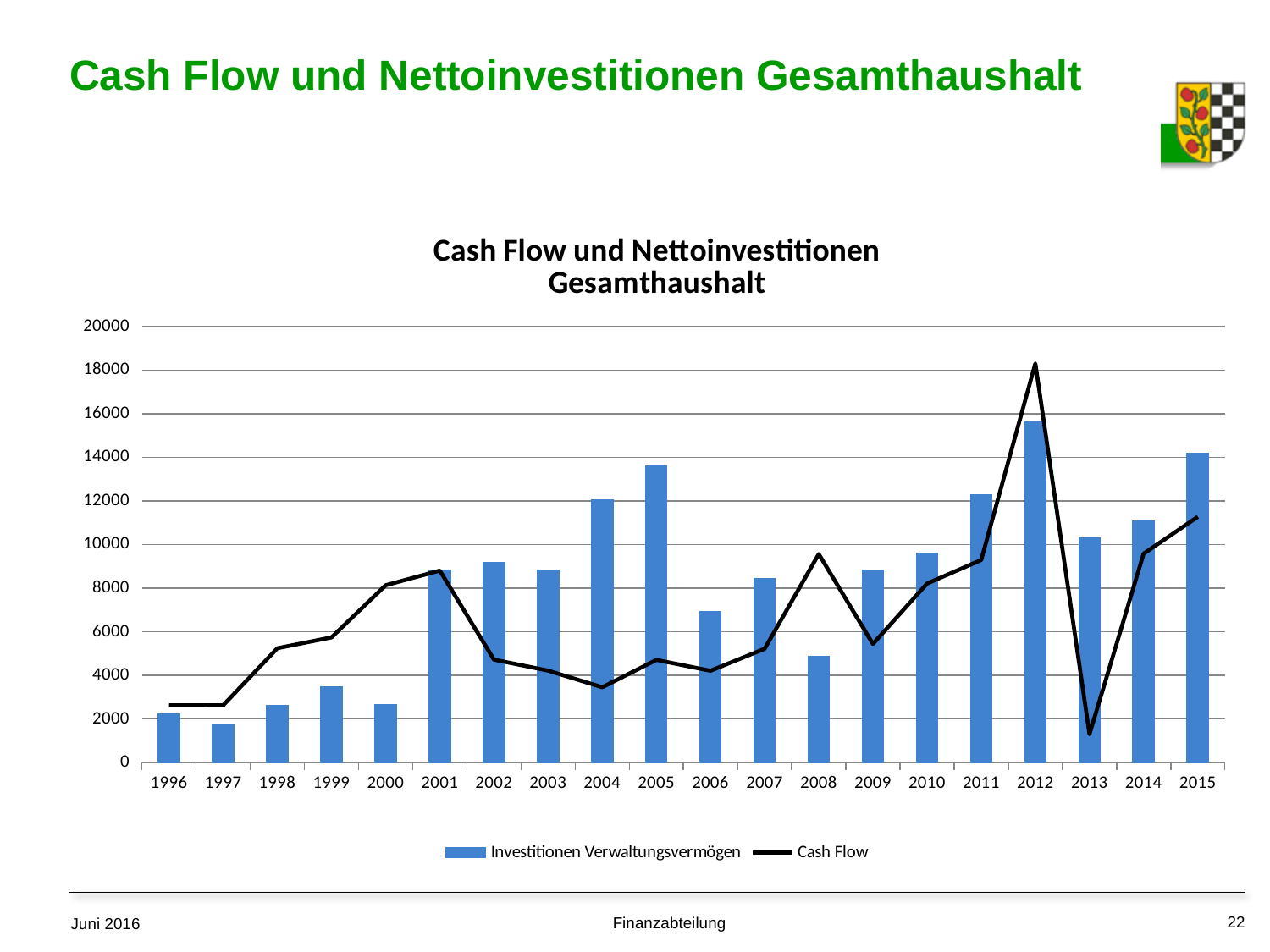
Does the Cash Flow line rise or fall from 2013 to 2015? rise Is the Investitionen Verwaltungsvermögen value for 2005 greater or less than 12000? greater How many years are shown on the x axis? 20 In which year is the Investitionen Verwaltungsvermögen bar the highest? 2012 Is the Cash Flow value for 2013 greater or less than 2000? less Which series is drawn as a black line? Cash Flow What type of chart is shown on the slide? A combined bar and line chart Which year has the larger Investitionen Verwaltungsvermögen bar, 2005 or 2006? 2005 In which year does the Cash Flow line reach its highest point? 2012 In which year does the Cash Flow line reach its lowest point? 2013 In which year is the Investitionen Verwaltungsvermögen bar the lowest? 1997 How many series does the legend list? 2